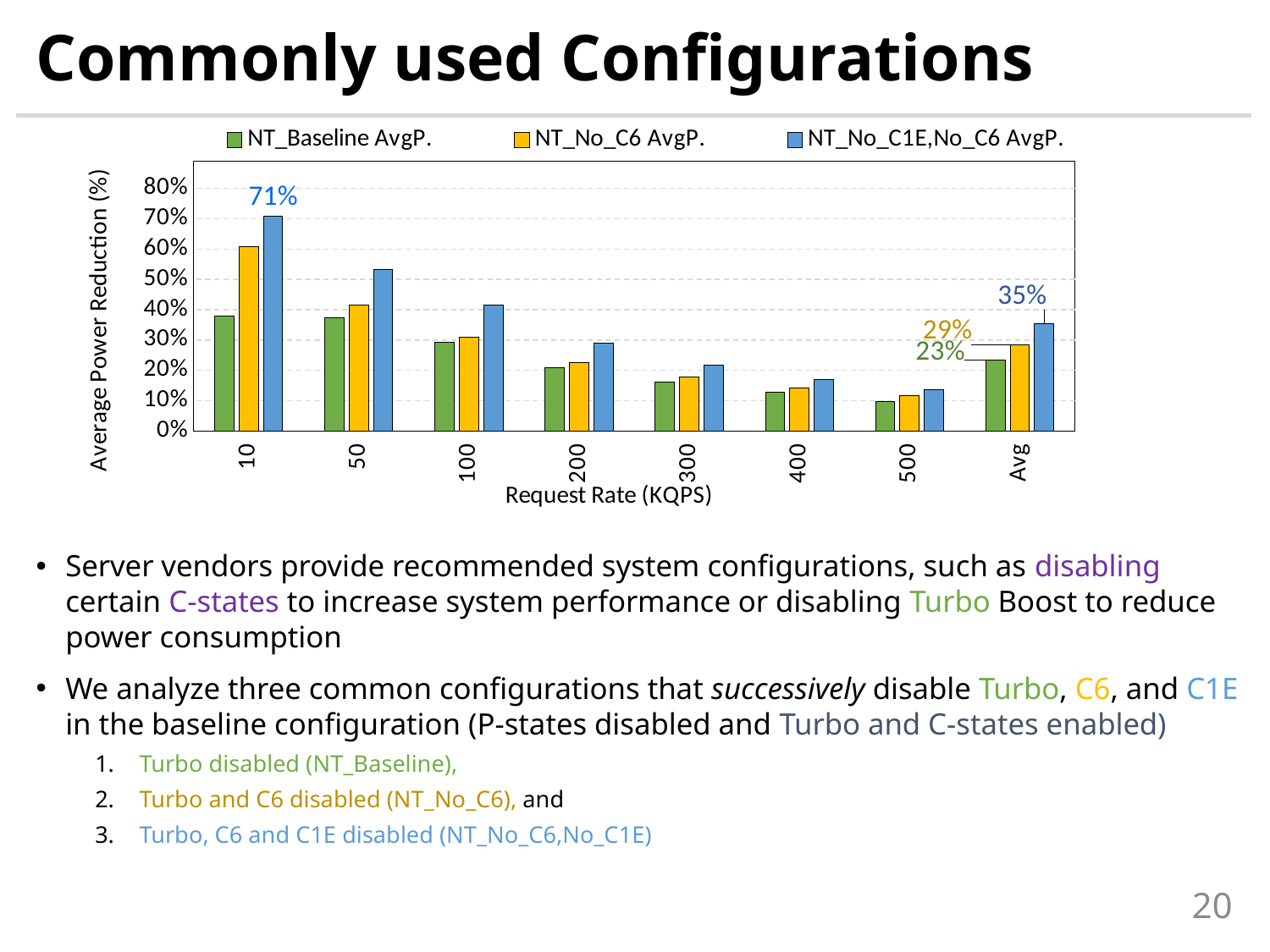
At which request rate is the NT_Baseline AvgP. value lowest? 500 What kind of chart is shown on the slide? bar chart What is the value for NT_No_C6 AvgP. in the Avg category? 29% How many series does the legend list? 3 Is the value for NT_No_C6 AvgP. at a request rate of 10 KQPS greater or less than 50%? greater In the Avg category, what is the difference between the NT_No_C1E,No_C6 AvgP. value and the NT_Baseline AvgP. value? 12% What is the value for NT_No_C1E,No_C6 AvgP. in the Avg category? 35% How many request rate categories are shown on the x axis? 8 What is the value for NT_No_C1E,No_C6 AvgP. at a request rate of 10 KQPS? 71% At which request rate is the NT_No_C1E,No_C6 AvgP. value highest? 10 What is the value for NT_Baseline AvgP. in the Avg category? 23% Do the NT_Baseline AvgP. values rise or fall as the request rate increases from 10 to 500 KQPS? fall